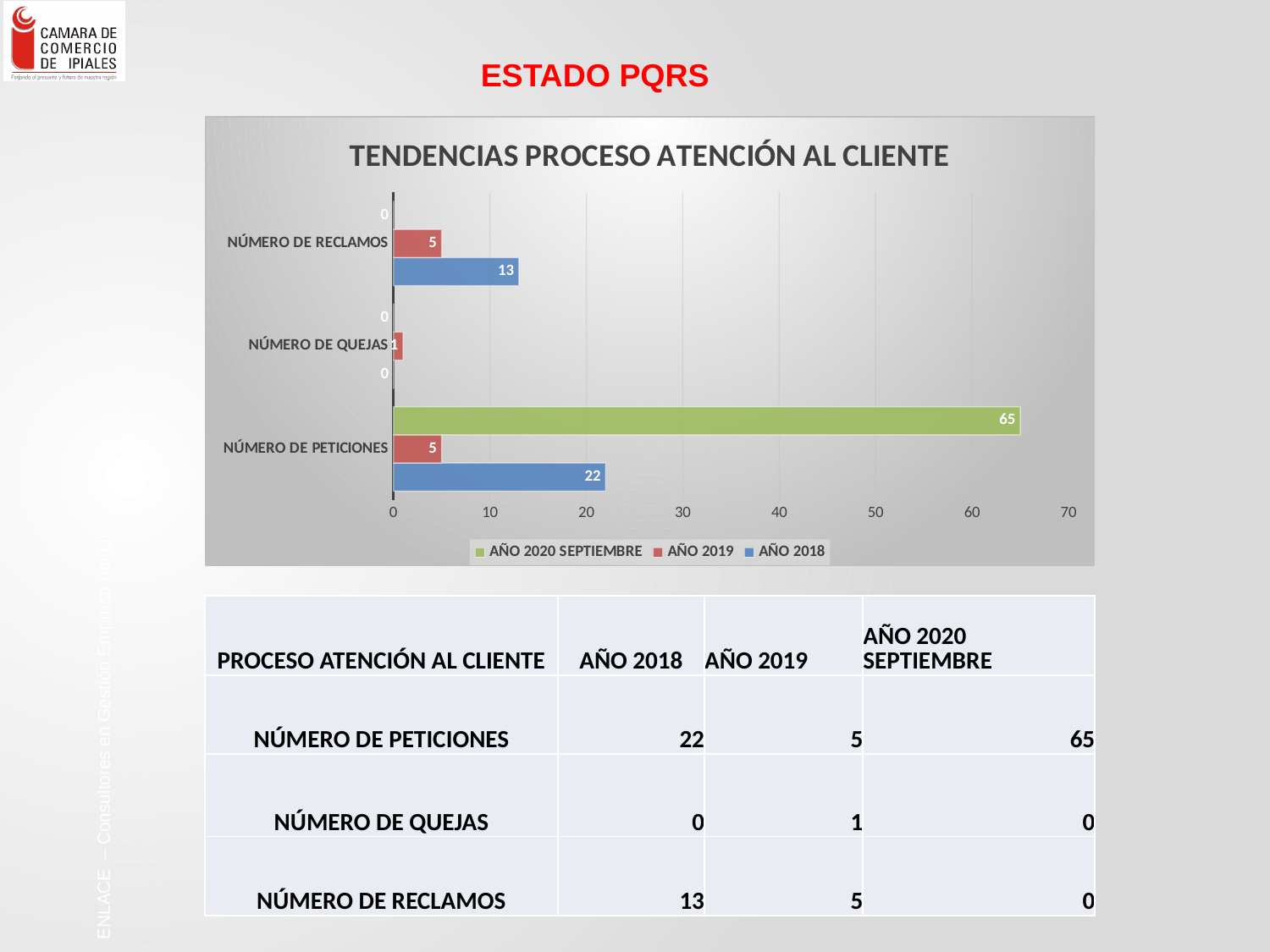
What kind of chart is shown on the slide? bar chart Which category has the lowest value in the AÑO 2019 series? NÚMERO DE QUEJAS What is the difference between the AÑO 2018 values for NÚMERO DE PETICIONES and NÚMERO DE RECLAMOS? 9 What is the value for NÚMERO DE RECLAMOS in the AÑO 2018 series? 13 What is the value for NÚMERO DE QUEJAS in the AÑO 2019 series? 1 What is the value for NÚMERO DE PETICIONES in the AÑO 2020 SEPTIEMBRE series? 65 Is the AÑO 2020 SEPTIEMBRE value for NÚMERO DE PETICIONES greater or less than 60? greater How many series does the legend list? 3 Which is larger for NÚMERO DE PETICIONES: the AÑO 2020 SEPTIEMBRE value or the AÑO 2018 value? AÑO 2020 SEPTIEMBRE How many categories are shown on the chart? 3 What is the value for NÚMERO DE PETICIONES in the AÑO 2019 series? 5 Which category has the highest value in the AÑO 2018 series? NÚMERO DE PETICIONES